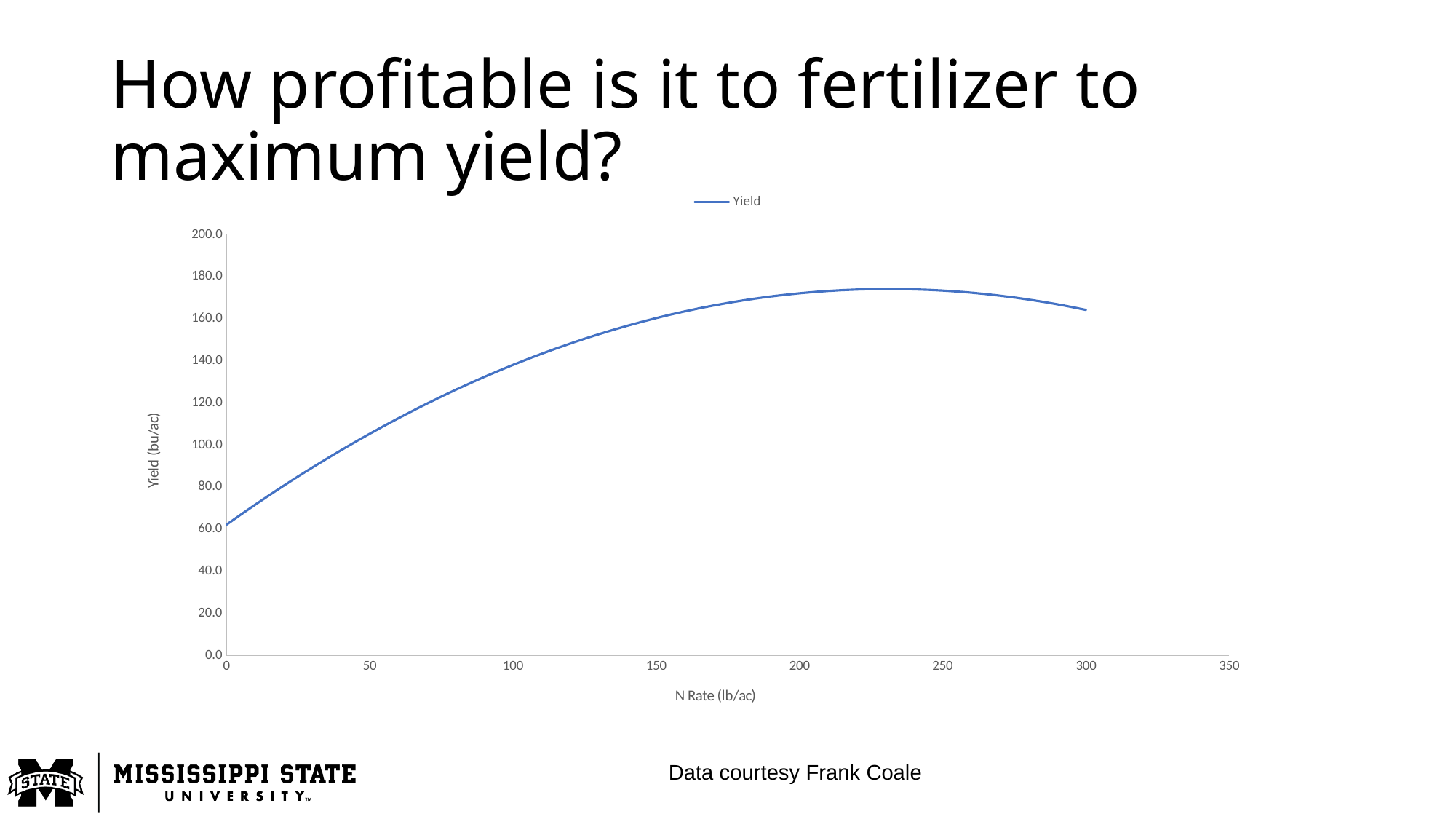
How many series does the chart's legend list? 1 Is the yield at an N rate of 0 greater or less than 80? less Does the yield rise or fall as the N rate increases from 0 to 200? rise What kind of chart is shown on the slide? line chart What is the label of the x axis? N Rate (lb/ac) Is the yield at an N rate of 50 greater or less than 120? less Is the yield at an N rate of 300 greater or less than 180? less What is the name of the series shown in the legend? Yield Which has the higher yield: an N rate of 50 or an N rate of 300? 300 Which has the higher yield: an N rate of 100 or an N rate of 200? 200